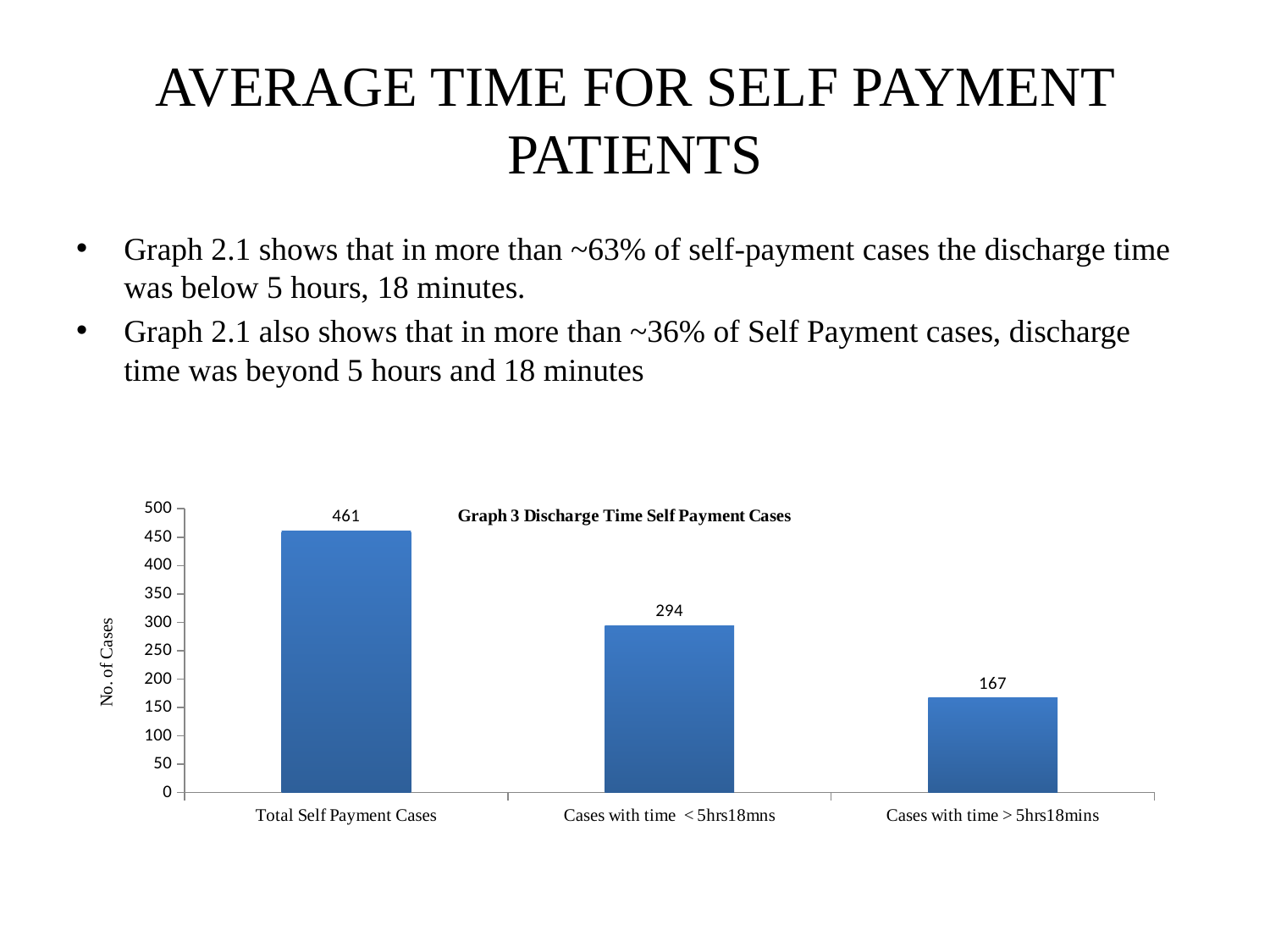
What is the value for Cases with time > 5hrs18mins? 167 What is the difference between Total Self Payment Cases and Cases with time < 5hrs18mns? 167 What is the value for Cases with time < 5hrs18mns? 294 Which is larger, Cases with time < 5hrs18mns or Cases with time > 5hrs18mins? Cases with time < 5hrs18mns Which category has the highest value? Total Self Payment Cases What is the value for Total Self Payment Cases? 461 What kind of chart is shown on the slide? bar chart What is the difference between Cases with time < 5hrs18mns and Cases with time > 5hrs18mins? 127 What is the title of the chart? Graph 3 Discharge Time Self Payment Cases Which category has the lowest value? Cases with time > 5hrs18mins How many categories are shown in the chart? 3 Is the value for Cases with time > 5hrs18mins greater or less than 200? less